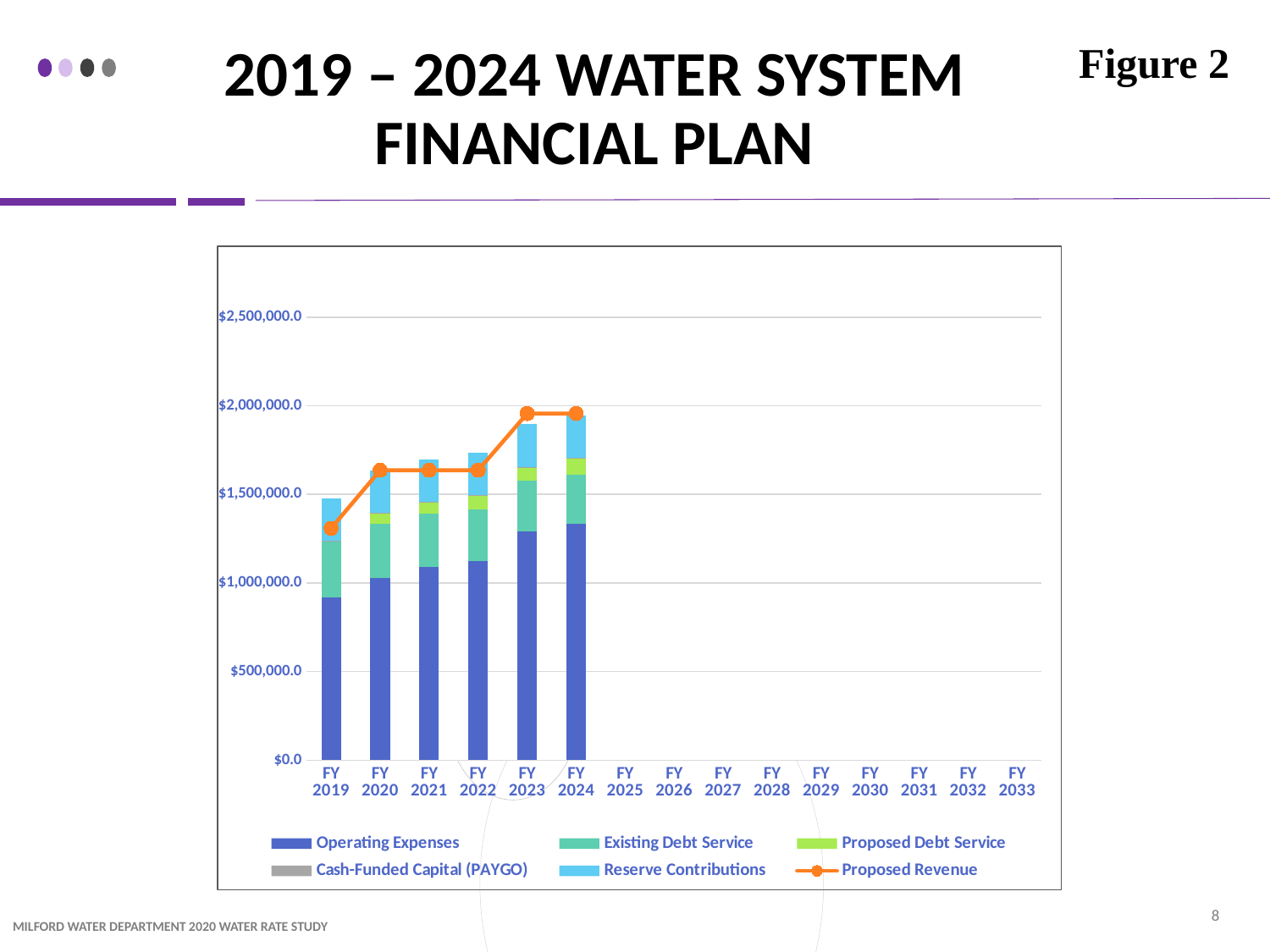
Is the Operating Expenses value for FY 2023 greater or less than $1,000,000.0? greater How many series does the legend list? 6 Is the Proposed Revenue value for FY 2023 greater or less than $1,500,000.0? greater Is the Operating Expenses value for FY 2019 greater or less than $1,000,000.0? less Which fiscal year has the lowest Proposed Revenue? FY 2019 Which series is drawn as an orange line with markers? Proposed Revenue What kind of chart is shown on the slide? Stacked bar chart with a line How many fiscal years have bars plotted in the chart? 6 Which fiscal year has the lowest Operating Expenses? FY 2019 Does the Proposed Revenue line rise or fall from FY 2019 to FY 2024? Rise How many fiscal year categories are shown on the x axis? 15